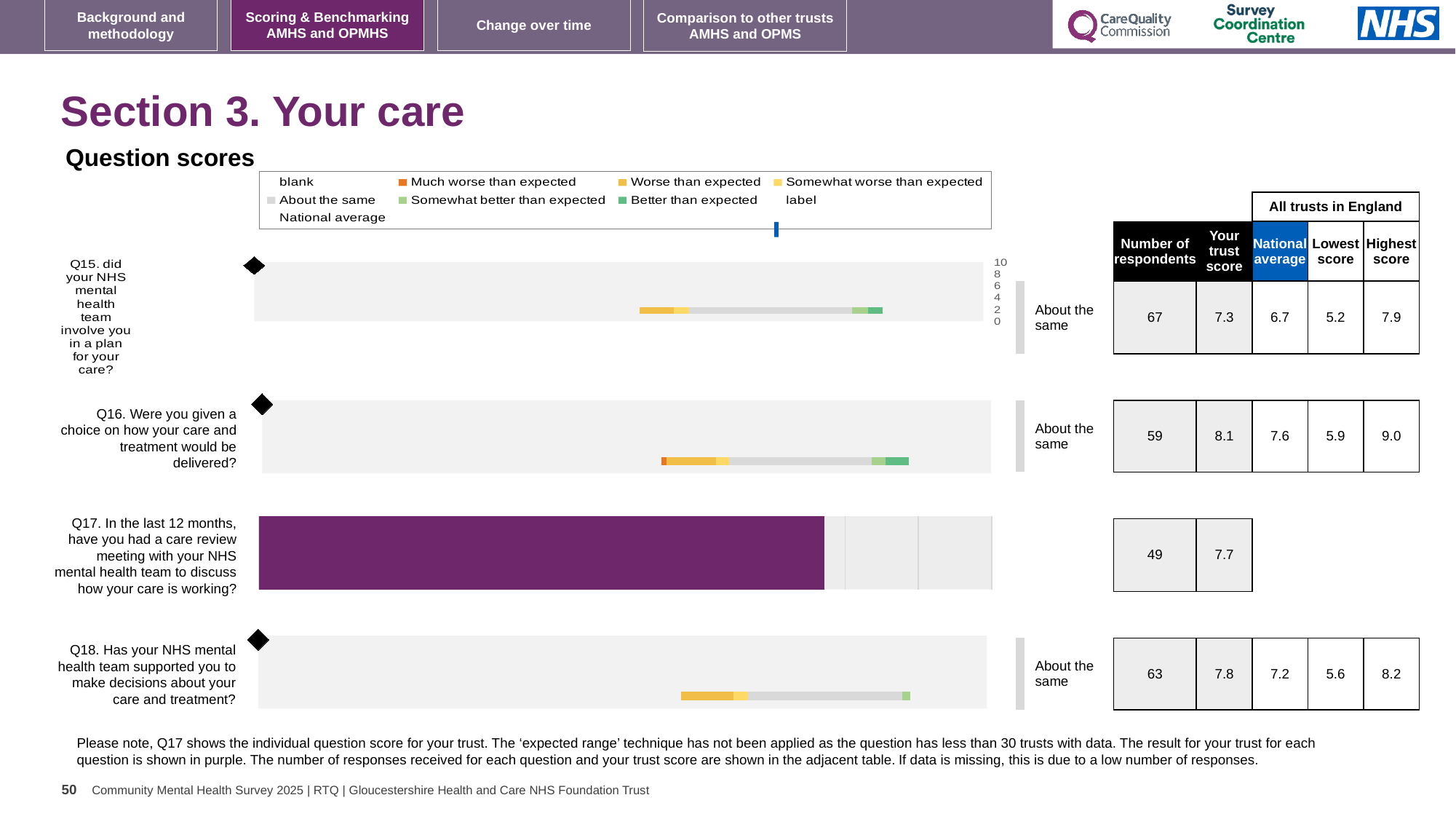
Which question's bar is shown in purple rather than with an expected range? Q17 What kind of chart is used to show the question scores? bar chart Which question has the fewest respondents? Q17 What is the trust score for Q16 (Were you given a choice on how your care and treatment would be delivered)? 8.1 What is the national average score for Q18 (Has your NHS mental health team supported you to make decisions about your care and treatment)? 7.2 How many respondents answered Q15 (did your NHS mental health team involve you in a plan for your care)? 67 What is the difference between the trust score and the national average for Q15? 0.6 What is the lowest score among all trusts in England for Q15? 5.2 For Q18, is the trust score higher or lower than the national average? higher What is the highest score among all trusts in England for Q16? 9.0 Which question has the highest trust score on this slide? Q16 How many questions are plotted in the Question scores chart? 4